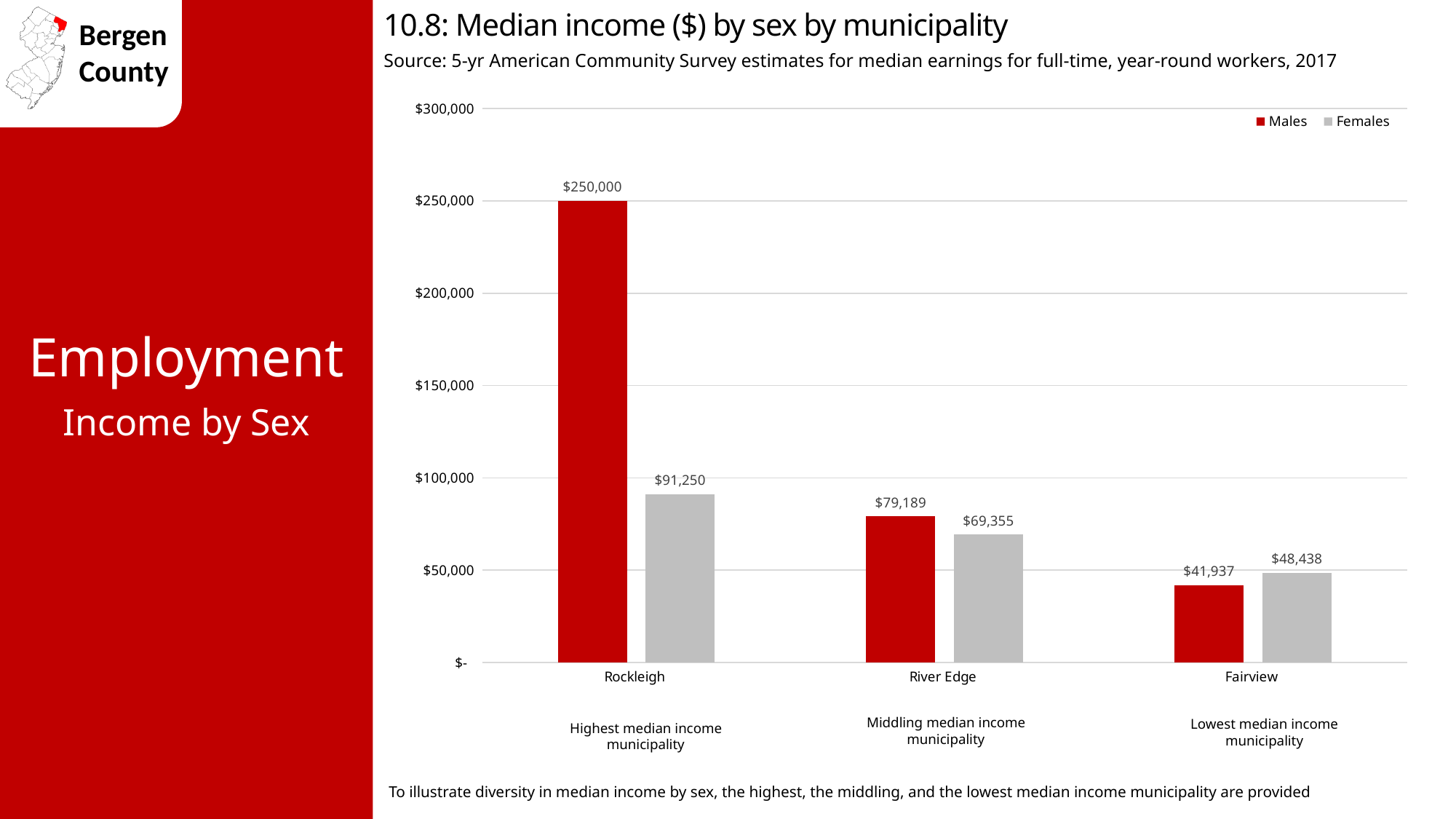
Which municipality has the lowest median income for males? Fairview What is the median income for males in Rockleigh? $250,000 Is the median income for females in Rockleigh greater or less than $100,000? less How many series does the legend list? 2 In Fairview, which is larger: the median income for males or for females? Females What kind of chart is shown on the slide? Bar chart Which municipality has the highest median income for females? Rockleigh What is the difference between female and male median income in Fairview? $6,501 What is the difference between male and female median income in Rockleigh? $158,750 What is the median income for females in River Edge? $69,355 How many municipalities are shown on the chart? 3 What is the median income for males in Fairview? $41,937